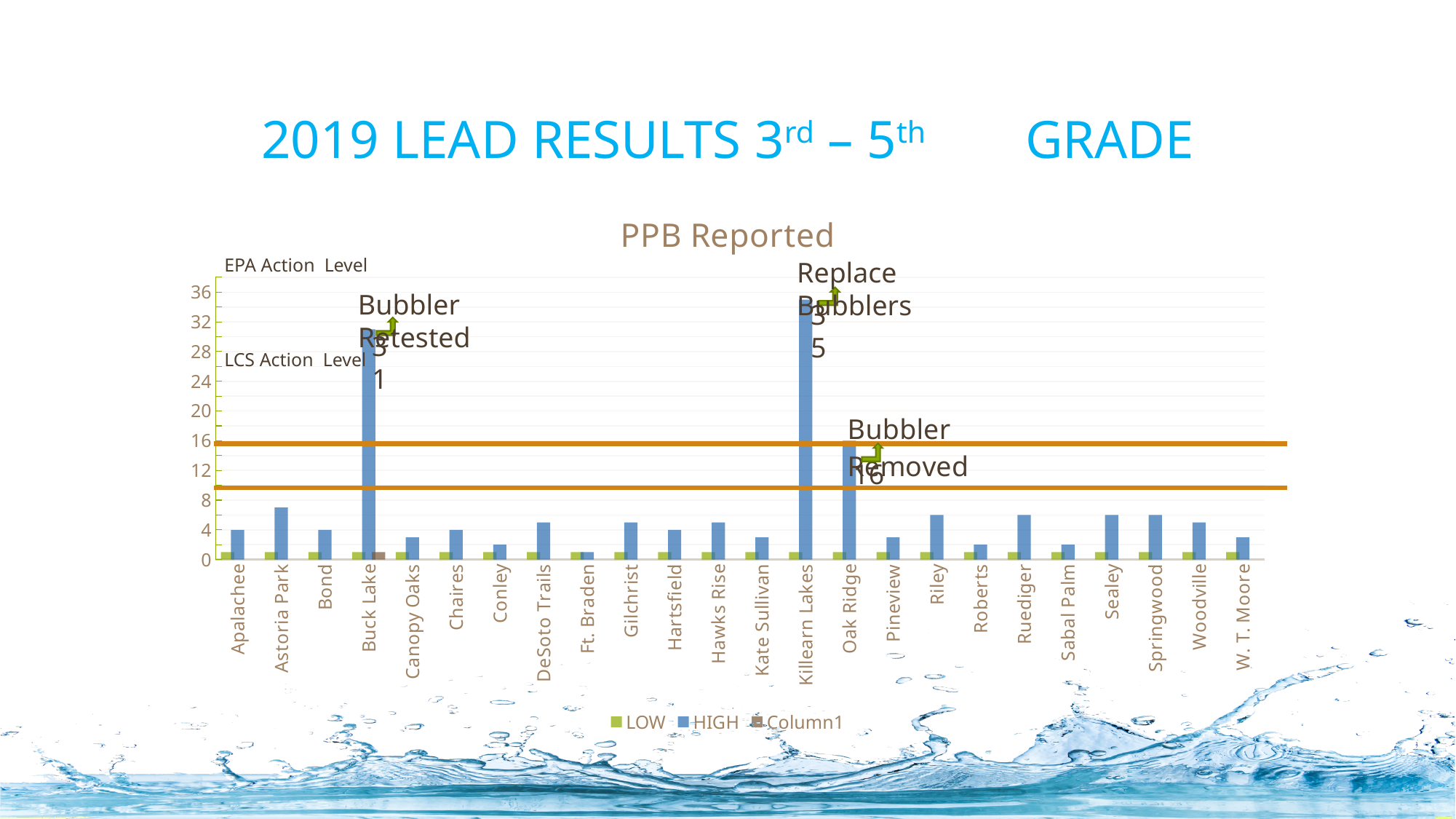
How many series does the chart legend list? 3 What is the title of the chart? PPB Reported Which school has the highest HIGH value in the chart? Killearn Lakes Which has the larger HIGH value, Astoria Park or Bond? Astoria Park What are the names of the two horizontal action-level lines labelled on the chart? EPA Action Level and LCS Action Level What kind of chart is shown on the slide? bar chart Is the HIGH value for Buck Lake greater or less than 28? greater How many schools (categories) are shown on the x axis of the chart? 24 Is the HIGH value for Killearn Lakes greater or less than 32? greater Which school has the lowest HIGH value in the chart? Ft. Braden Is the HIGH value for Conley greater or less than 4? less What is the HIGH value labelled for Oak Ridge? 16